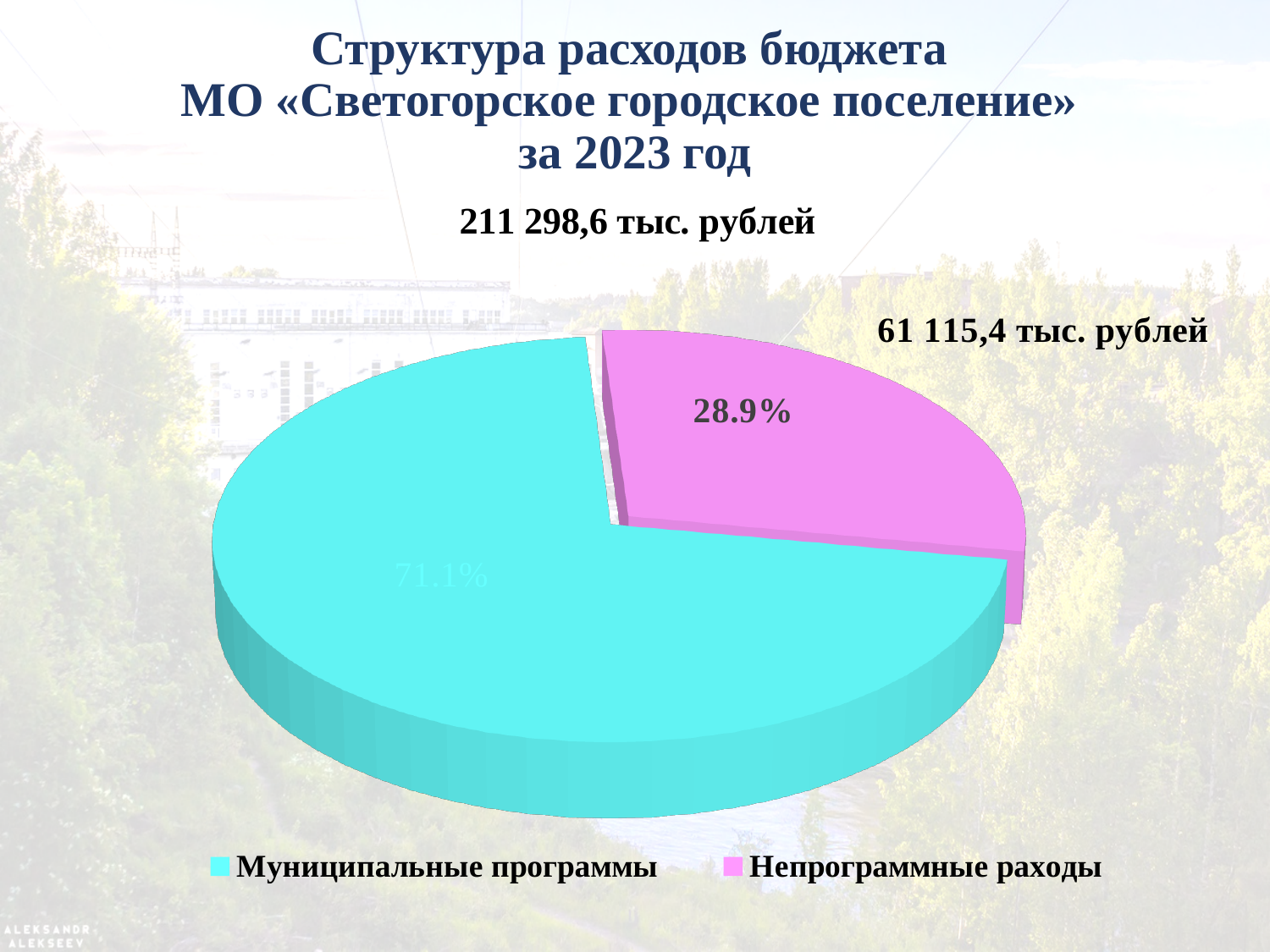
How many slices does the pie chart have? 2 Which is larger, the share for Муниципальные программы or for Непрограммные раходы? Муниципальные программы What share of the pie does Муниципальные программы take? 71.1% What share of the pie does Непрограммные раходы take? 28.9% What colour is the Непрограммные раходы slice? pink Which category has the smallest share of the pie? Непрограммные раходы What is the difference in percentage points between the Муниципальные программы and Непрограммные раходы shares? 42.2 What value is printed next to the Непрограммные раходы slice? 61 115,4 тыс. рублей How many entries does the legend list? 2 Which category has the largest share of the pie? Муниципальные программы What kind of chart is shown on the slide? pie chart